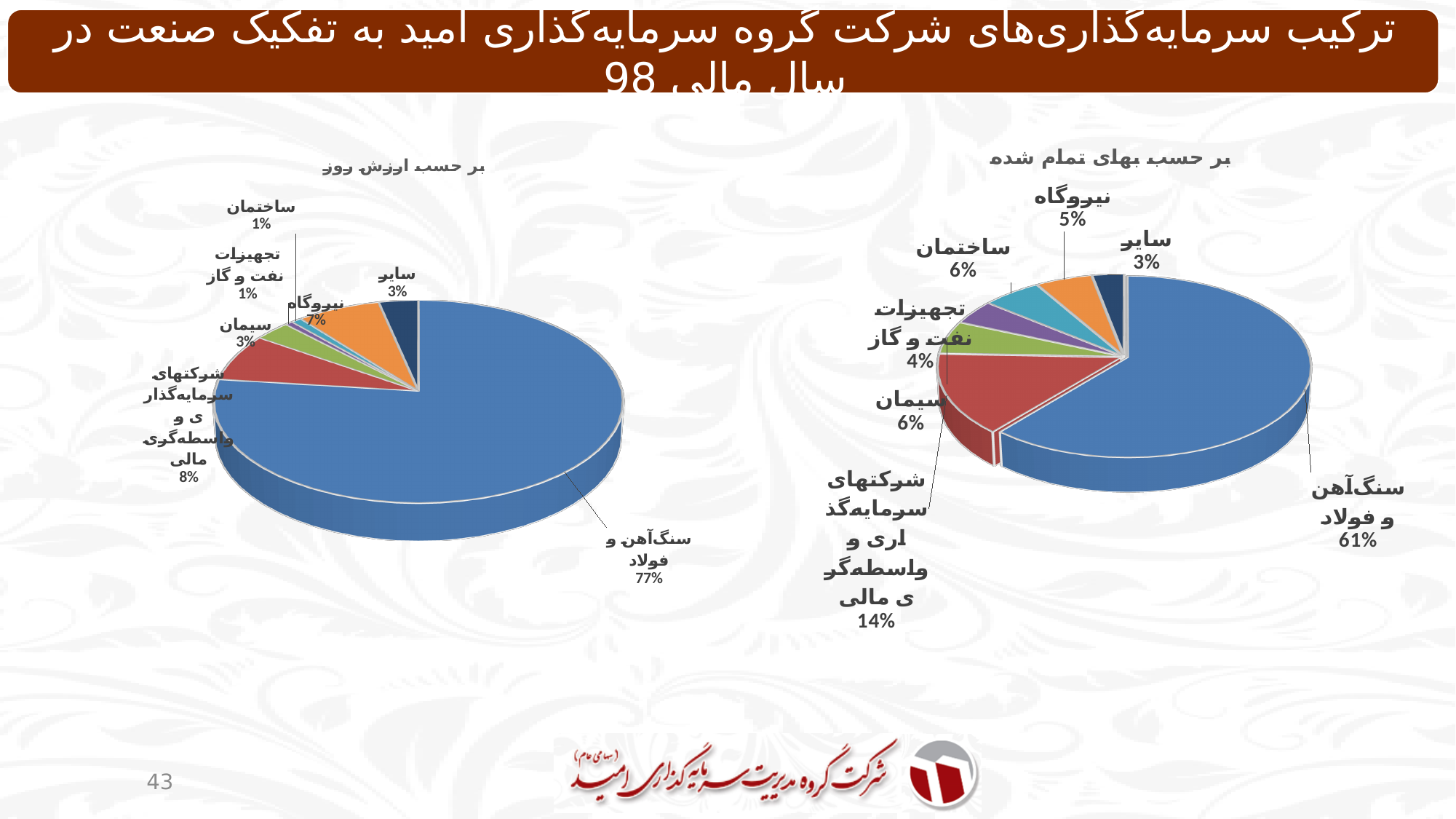
In the left-hand pie chart (بر حسب ارزش روز), which category has the largest slice? سنگ‌آهن و فولاد In the right-hand pie chart (بر حسب بهای تمام شده), what share does سنگ‌آهن و فولاد have? 61% How many categories are shown in the left-hand pie chart (بر حسب ارزش روز)? 7 What is the title of the right-hand chart? بر حسب بهای تمام شده What type of chart is used on this slide? Pie chart What is the difference between the share of سنگ‌آهن و فولاد in the left-hand chart (77%) and in the right-hand chart (61%)? 16% In the right-hand pie chart (بر حسب بهای تمام شده), what share does شرکتهای سرمایه‌گذاری و واسطه‌گری مالی have? 14% In the left-hand pie chart (بر حسب ارزش روز), what share does سنگ‌آهن و فولاد have? 77% In the left-hand pie chart (بر حسب ارزش روز), what share does نیروگاه have? 7% In the right-hand pie chart (بر حسب بهای تمام شده), what share does تجهیزات نفت و گاز have? 4% In the right-hand pie chart (بر حسب بهای تمام شده), which is larger: the share of سیمان or the share of نیروگاه? سیمان In the right-hand pie chart (بر حسب بهای تمام شده), which category has the smallest slice? سایر